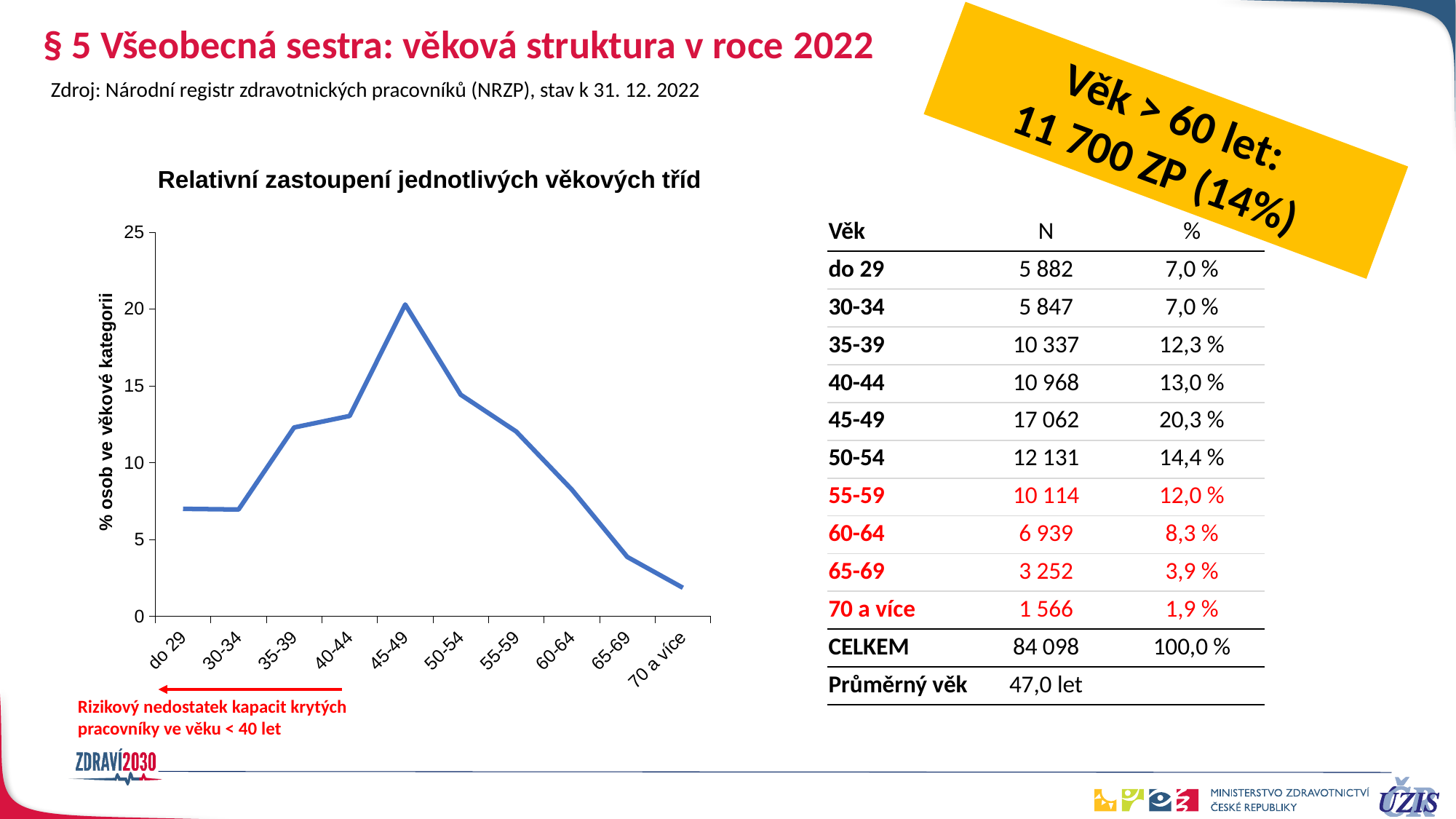
Is the value for 35-39 greater or less than 10? greater Which age category has the lowest value in the chart? 70 a více What is the title of the chart? Relativní zastoupení jednotlivých věkových tříd How many age categories are plotted along the x axis of the chart? 10 What kind of chart is shown on the slide? line chart Is the value for 65-69 greater or less than 5? less Is the value for 50-54 greater or less than 15? less What is the difference between the percentage for 45-49 and the percentage for 50-54? 5,9 % What is the percentage share for the 45-49 age category? 20,3 % Which age category has the highest value in the chart? 45-49 Which has the larger value, 40-44 or 60-64? 40-44 Do the values rise or fall along the x axis from 45-49 to 70 a více? fall